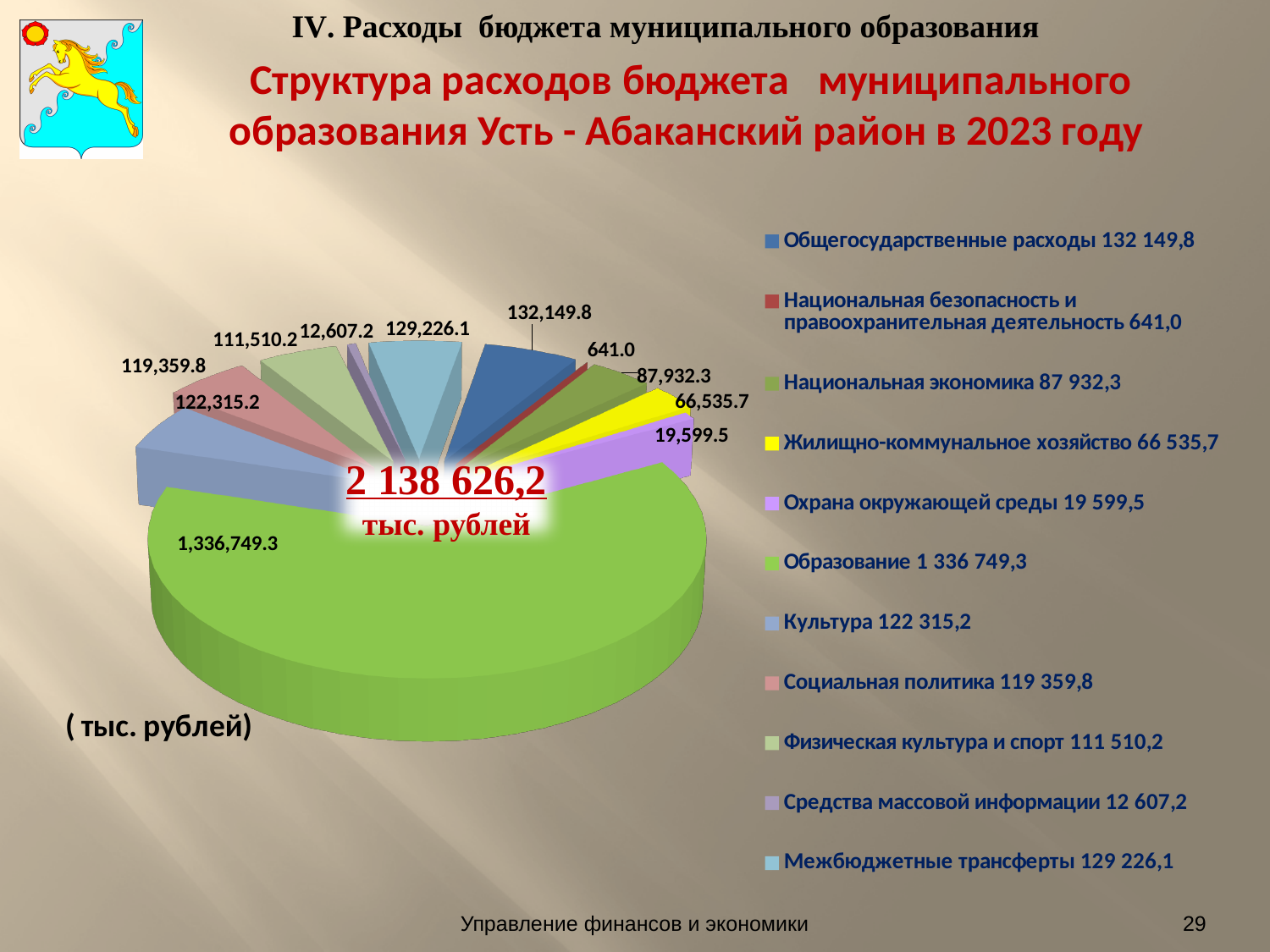
What is the value for Жилищно-коммунальное хозяйство on the pie chart? 66,535.7 Which category has the smallest slice of the pie chart? Национальная безопасность и правоохранительная деятельность What total value is printed in the centre of the pie chart? 2 138 626,2 тыс. рублей What is the difference between Общегосударственные расходы and Межбюджетные трансферты on the pie chart? 2,923.7 What is the difference between Национальная экономика and Жилищно-коммунальное хозяйство on the pie chart? 21,396.6 What is the value for Образование on the pie chart? 1,336,749.3 What is the value for Средства массовой информации on the pie chart? 12,607.2 Which category has the largest slice of the pie chart? Образование How many categories does the pie chart have? 11 What kind of chart is shown on the slide? Pie chart What is the value for Межбюджетные трансферты on the pie chart? 129,226.1 Which is larger on the pie chart: Культура or Социальная политика? Культура